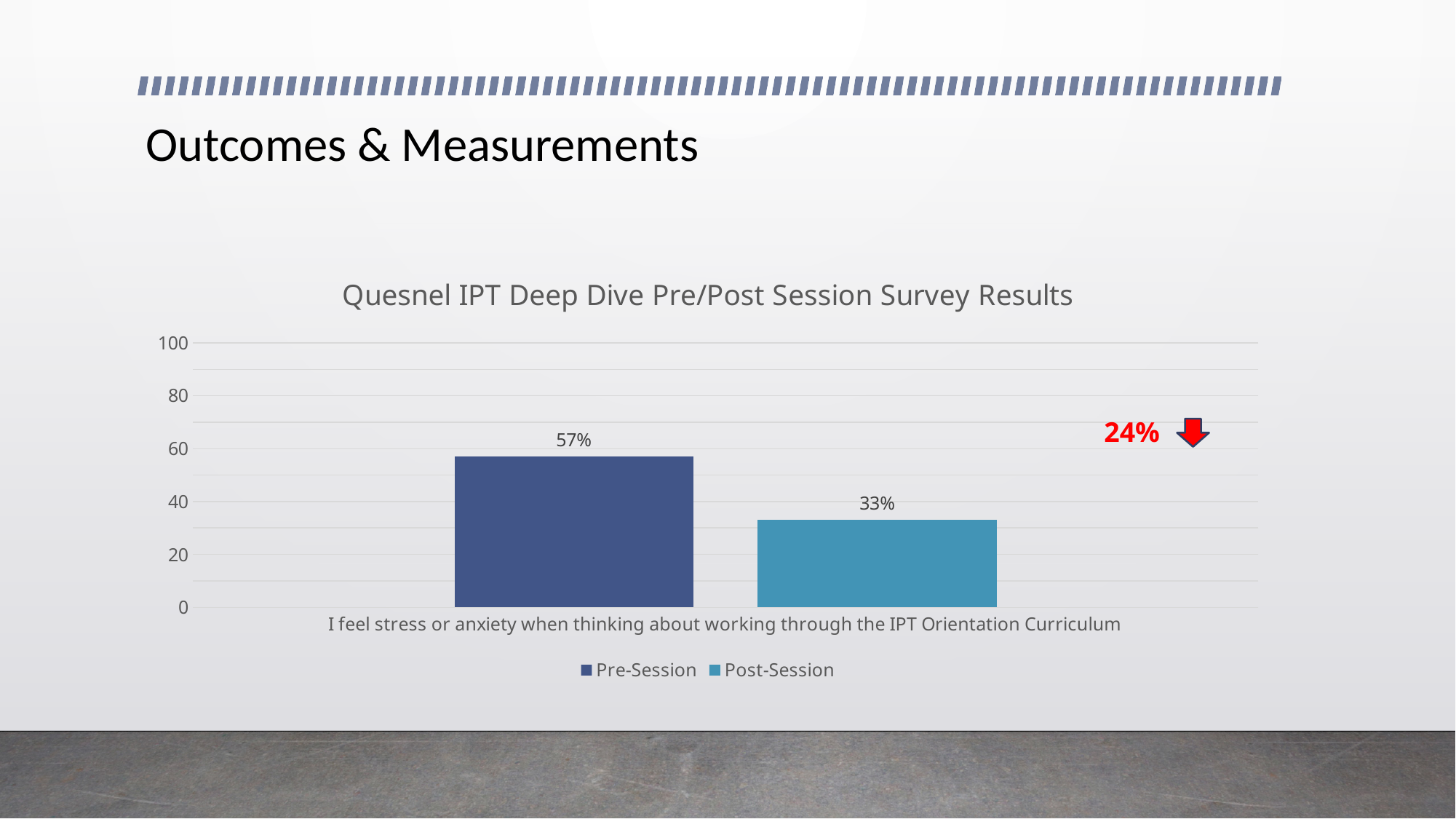
What is the Pre-Session value for "I feel stress or anxiety when thinking about working through the IPT Orientation Curriculum"? 57% What kind of chart is shown on the slide? Bar chart What is the difference between the Pre-Session and Post-Session values? 24% Is the Pre-Session value greater or less than 60? less Is the Post-Session value greater or less than 40? less Which series has the lowest value? Post-Session What is the Post-Session value for "I feel stress or anxiety when thinking about working through the IPT Orientation Curriculum"? 33% How many series does the legend list? 2 Which series has the higher value, Pre-Session or Post-Session? Pre-Session How many categories are shown on the x axis? 1 What percentage change is annotated in red next to the downward arrow? 24% What is the title of the chart? Quesnel IPT Deep Dive Pre/Post Session Survey Results